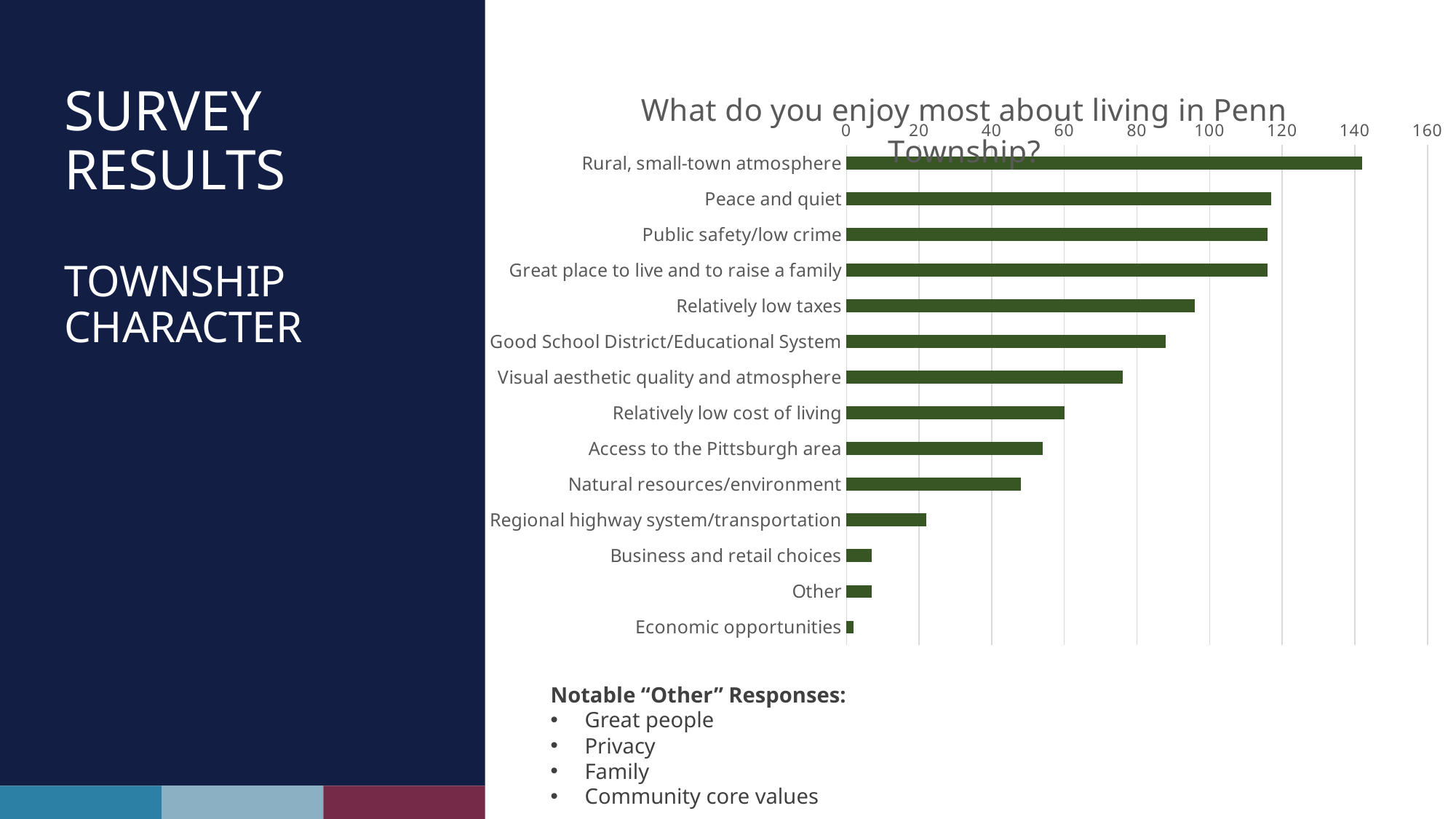
Is the value for Relatively low taxes greater or less than 100? less Which is larger, the value for Peace and quiet or the value for Relatively low taxes? Peace and quiet Which category has the highest value in the chart? Rural, small-town atmosphere How many categories are plotted in the chart? 14 Is the value for Regional highway system/transportation greater or less than 40? less What kind of chart is shown on the slide? Bar chart Which is larger, the value for Access to the Pittsburgh area or the value for Natural resources/environment? Access to the Pittsburgh area Is the value for Rural, small-town atmosphere greater or less than 140? greater What is the title of the chart? What do you enjoy most about living in Penn Township? Which category has the lowest value in the chart? Economic opportunities Do the bar values increase or decrease going from the top category to the bottom category? decrease